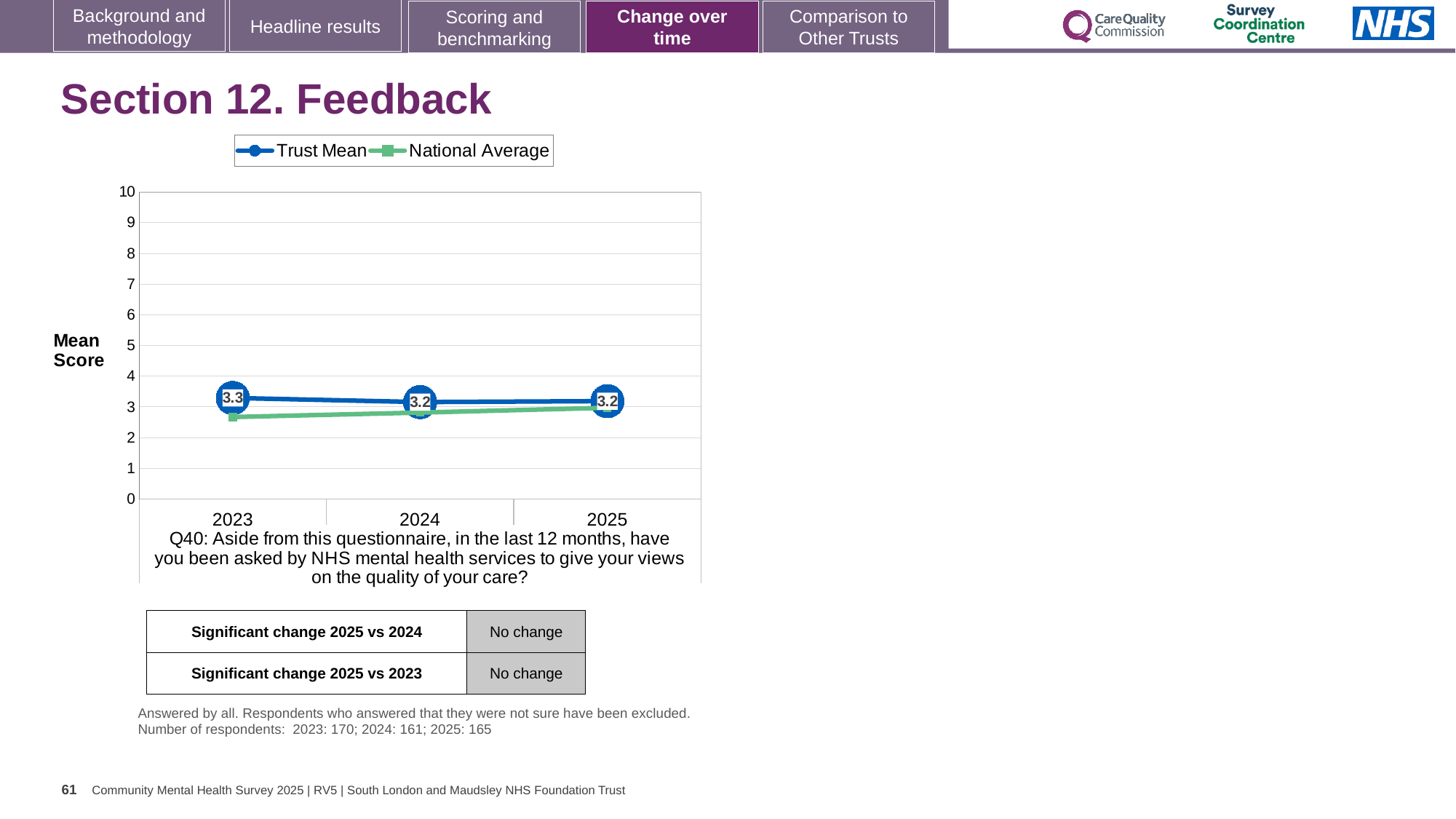
What is the Trust Mean value for 2024? 3.2 How many series does the legend list? 2 Does the National Average rise or fall from 2023 to 2025? Rise In 2023, which is larger: the Trust Mean or the National Average? Trust Mean What is the label on the y axis of the chart? Mean Score What is the Trust Mean value for 2023? 3.3 What is the Trust Mean value for 2025? 3.2 Is the National Average value for 2023 greater or less than 3? less What is the difference between the Trust Mean in 2023 and in 2025? 0.1 How many years are plotted on the x axis? 3 What kind of chart is shown on the slide? Line chart In which year is the Trust Mean highest? 2023